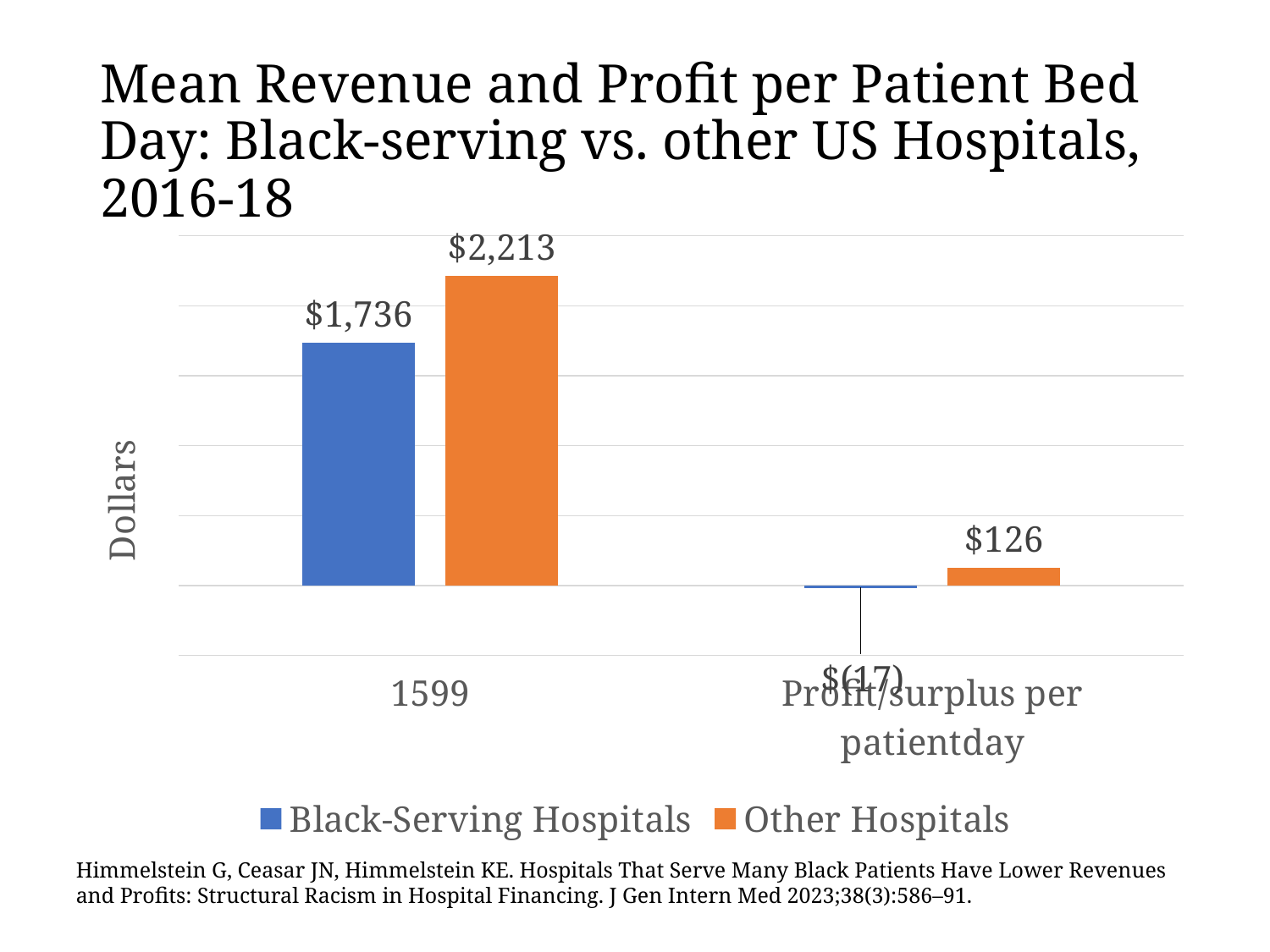
How many series does the legend list? 2 What is the profit/surplus per patient day for Other Hospitals? $126 How many categories are shown on the x axis? 2 What is the value for Other Hospitals in the category labelled 1599? $2,213 Which bar in the chart is the tallest? Other Hospitals in the category labelled 1599 ($2,213) What colour represents Other Hospitals in the chart? orange Which series has the lower profit/surplus per patient day? Black-Serving Hospitals What type of chart is shown on the slide? bar chart What is the difference between Other Hospitals and Black-Serving Hospitals in the category labelled 1599? $477 What is the profit/surplus per patient day for Black-Serving Hospitals? $(17) Which series has the higher value in the category labelled 1599? Other Hospitals What is the value for Black-Serving Hospitals in the category labelled 1599? $1,736